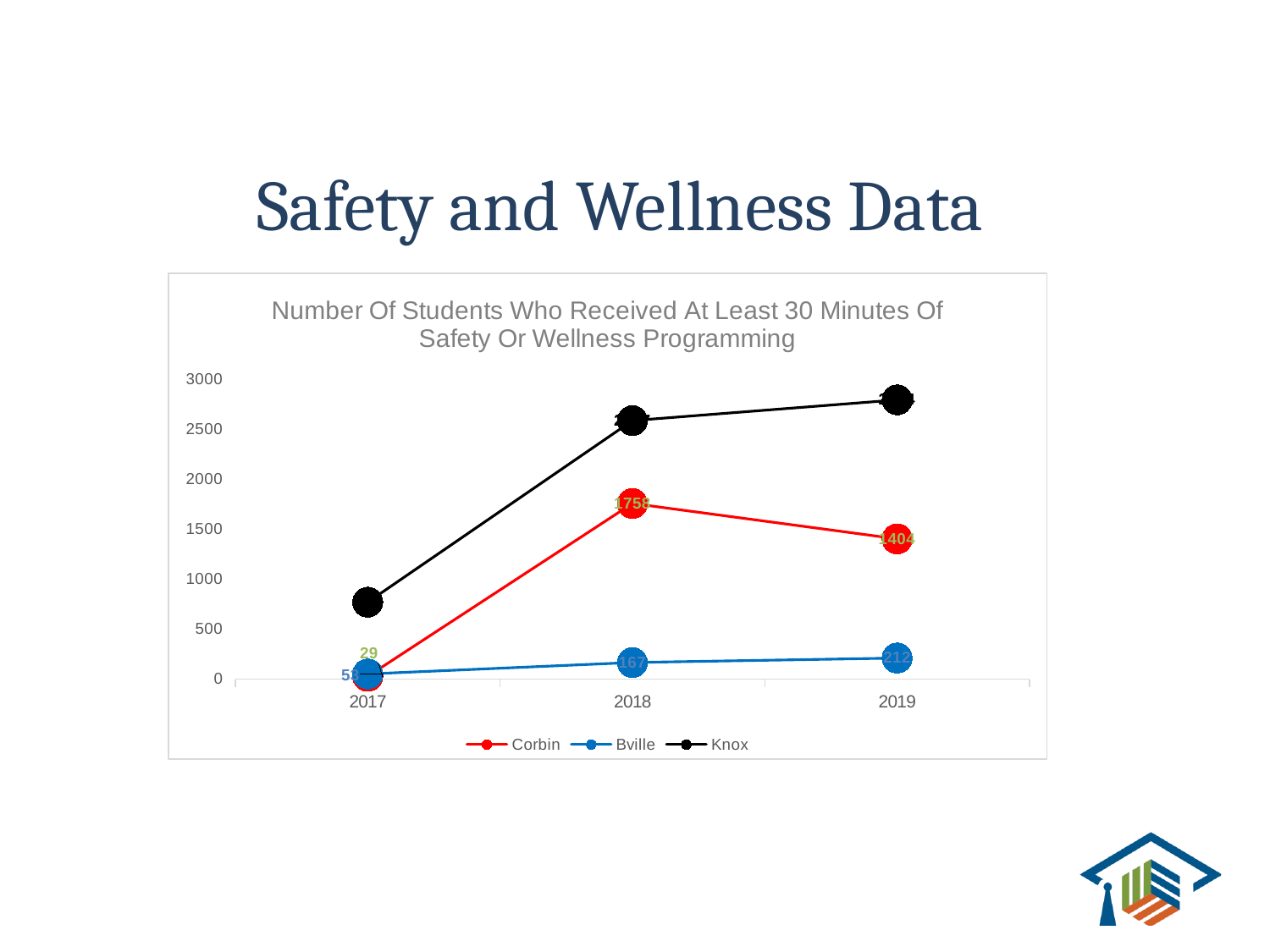
Is the value for Knox in 2017 greater or less than 1000? less How many series does the legend list? 3 How many years are shown on the x axis? 3 By how much did Corbin's value fall from 2018 to 2019? 354 What is the value for Corbin in 2018? 1758 What type of chart is shown on the slide? Line chart What is the difference between Bville's 2019 and 2018 values? 45 Does the Knox line rise or fall from 2017 to 2019? Rises What is the value for Bville in 2019? 212 Which series has the highest value in 2019? Knox What is the value for Corbin in 2019? 1404 What is the value for Bville in 2018? 167